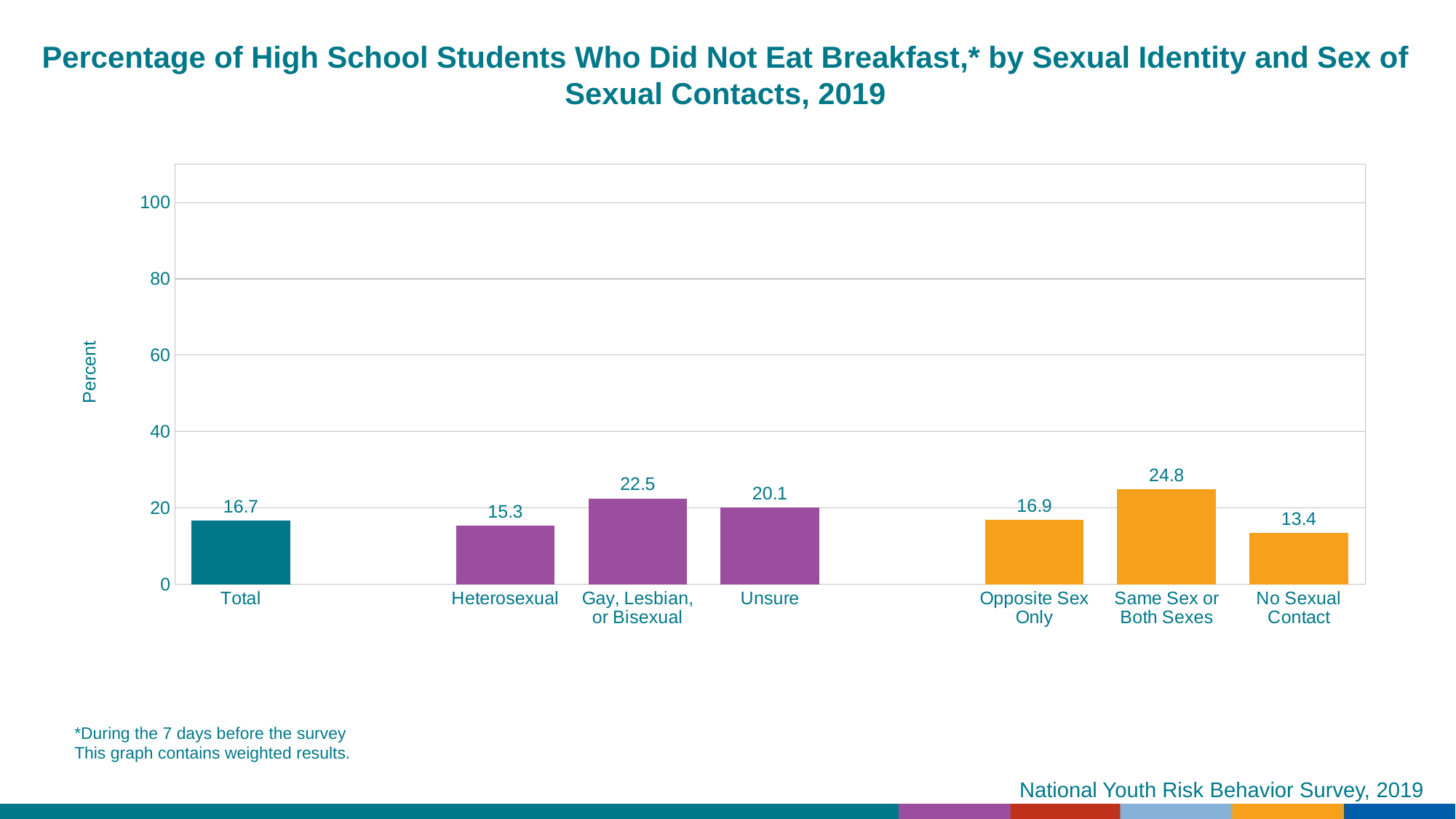
What is the label of the y axis? Percent Which category has the lowest value? No Sexual Contact What is the difference between the values for Same Sex or Both Sexes and Opposite Sex Only? 7.9 What is the value for Gay, Lesbian, or Bisexual students? 22.5 What kind of chart is this? bar chart What is the value for No Sexual Contact? 13.4 Which category has the highest value? Same Sex or Both Sexes Which is larger, the value for Unsure or the value for Heterosexual? Unsure How many bars are shown in the chart? 7 What is the difference between the values for Gay, Lesbian, or Bisexual and Heterosexual? 7.2 What is the value for Total? 16.7 Is the value for Same Sex or Both Sexes greater or less than 20? greater